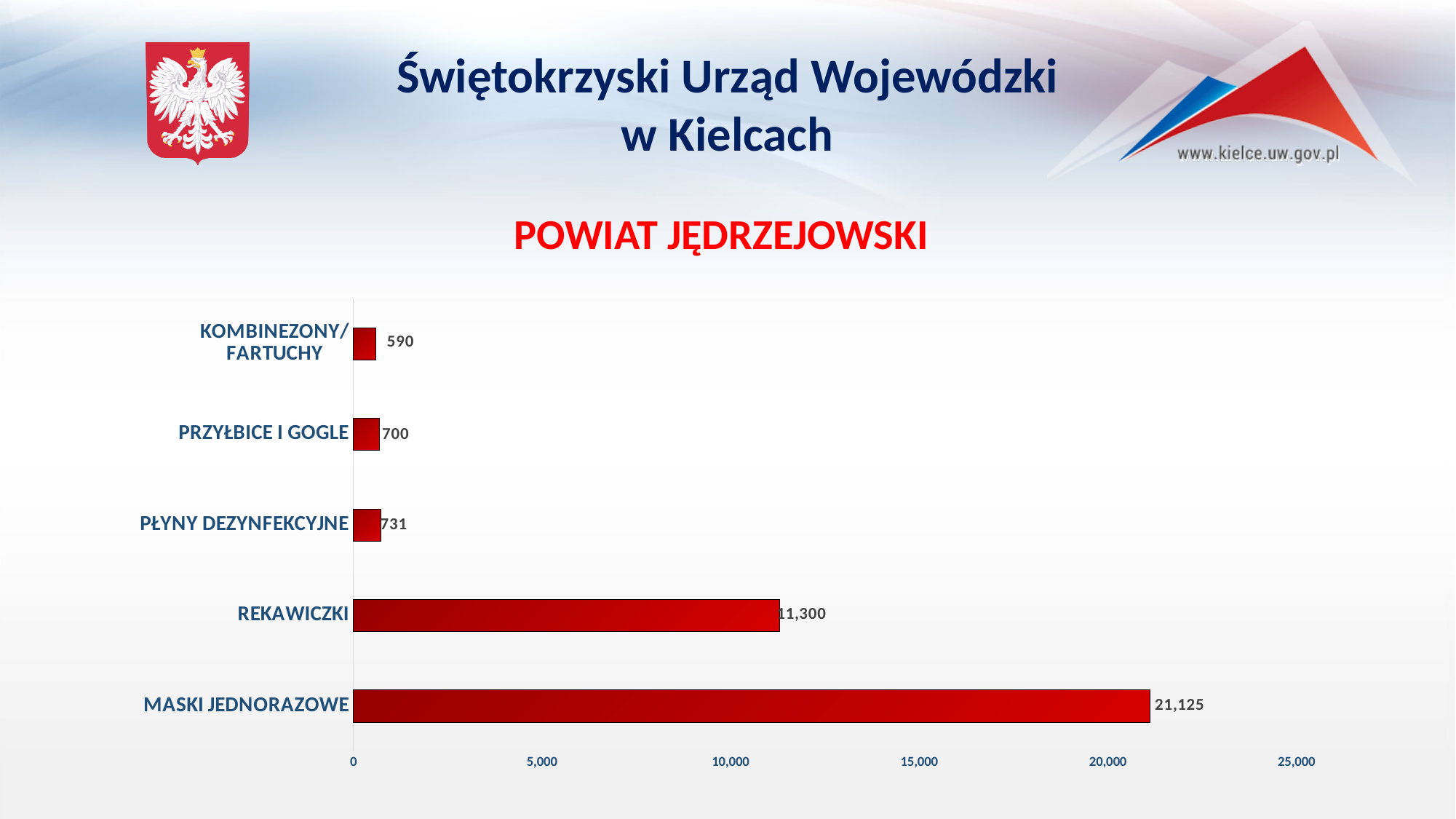
What kind of chart is shown on the slide? bar chart Which is larger, the value for PŁYNY DEZYNFEKCYJNE or PRZYŁBICE I GOGLE? PŁYNY DEZYNFEKCYJNE Which category has the lowest value? KOMBINEZONY/FARTUCHY What is the value for PŁYNY DEZYNFEKCYJNE? 731 How many categories are shown in the chart? 5 What is the value for KOMBINEZONY/FARTUCHY? 590 What is the difference between the values for MASKI JEDNORAZOWE and REKAWICZKI? 9,825 What is the value for MASKI JEDNORAZOWE? 21,125 Is the value for REKAWICZKI greater or less than 10,000? greater Which category has the highest value? MASKI JEDNORAZOWE What is the value for REKAWICZKI? 11,300 What is the value for PRZYŁBICE I GOGLE? 700